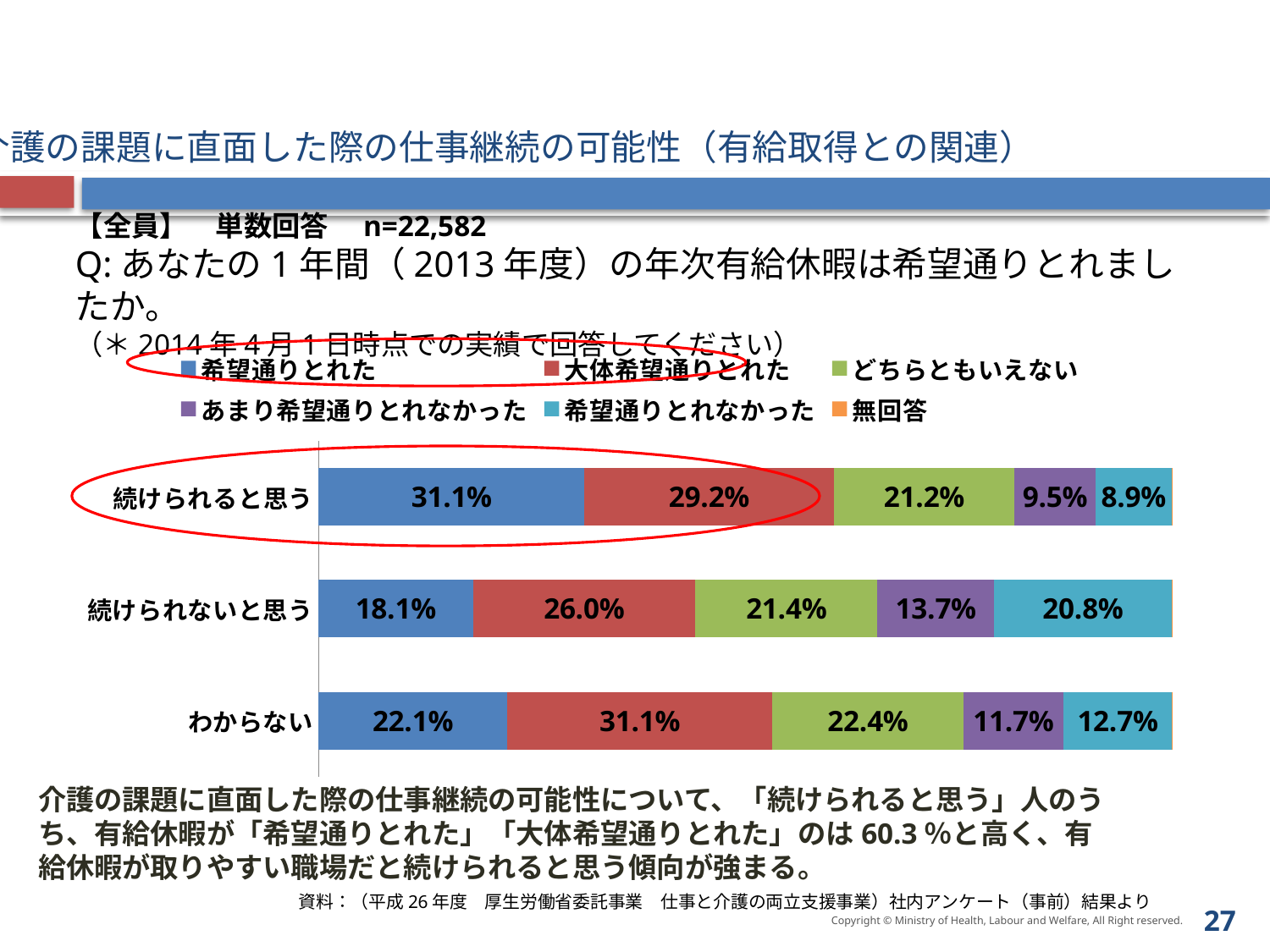
Which category has the highest value for 希望通りとれた? 続けられると思う What is the difference between 希望通りとれた for 続けられると思う and for 続けられないと思う? 13.0% Which is larger: 希望通りとれなかった for 続けられないと思う or for わからない? 続けられないと思う Which category has the lowest value for 希望通りとれなかった? 続けられると思う What is the value of 希望通りとれなかった for わからない? 12.7% What kind of chart is shown on the slide? Stacked bar chart What is the value of あまり希望通りとれなかった for 続けられると思う? 9.5% What is the value of 大体希望通りとれた for 続けられないと思う? 26.0% How many categories (bars) does the chart show? 3 What is the n (sample size) shown above the chart? n=22,582 What is the value of 希望通りとれた for 続けられると思う? 31.1% How many series does the legend list? 6